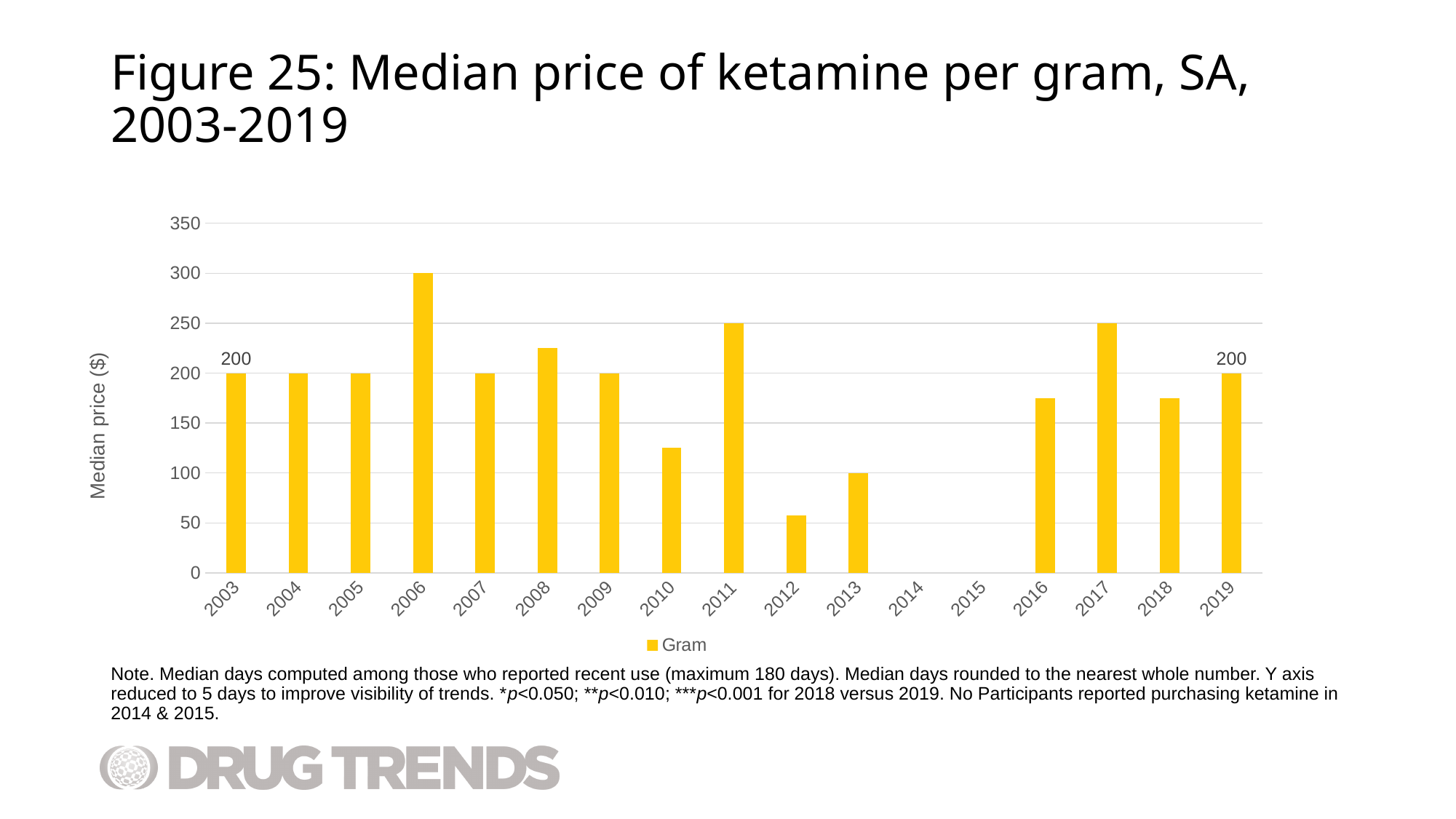
Is the value for 2016 greater or less than 150? greater What is the median price of ketamine per gram in 2006? 300 Is the median price of ketamine per gram in 2011 larger than in 2010? Yes What is the median price of ketamine per gram in 2003? 200 Which year has the highest median price of ketamine per gram? 2006 What is the single series listed in the chart legend? Gram What is the median price of ketamine per gram in 2019? 200 Among the years with a bar shown, which year has the lowest median price of ketamine per gram? 2012 What kind of chart is shown on the slide? bar chart Is the value for 2012 greater or less than 100? less What is the difference between the median price in 2003 and the median price in 2019? 0 How many years are shown on the x axis of the chart? 17